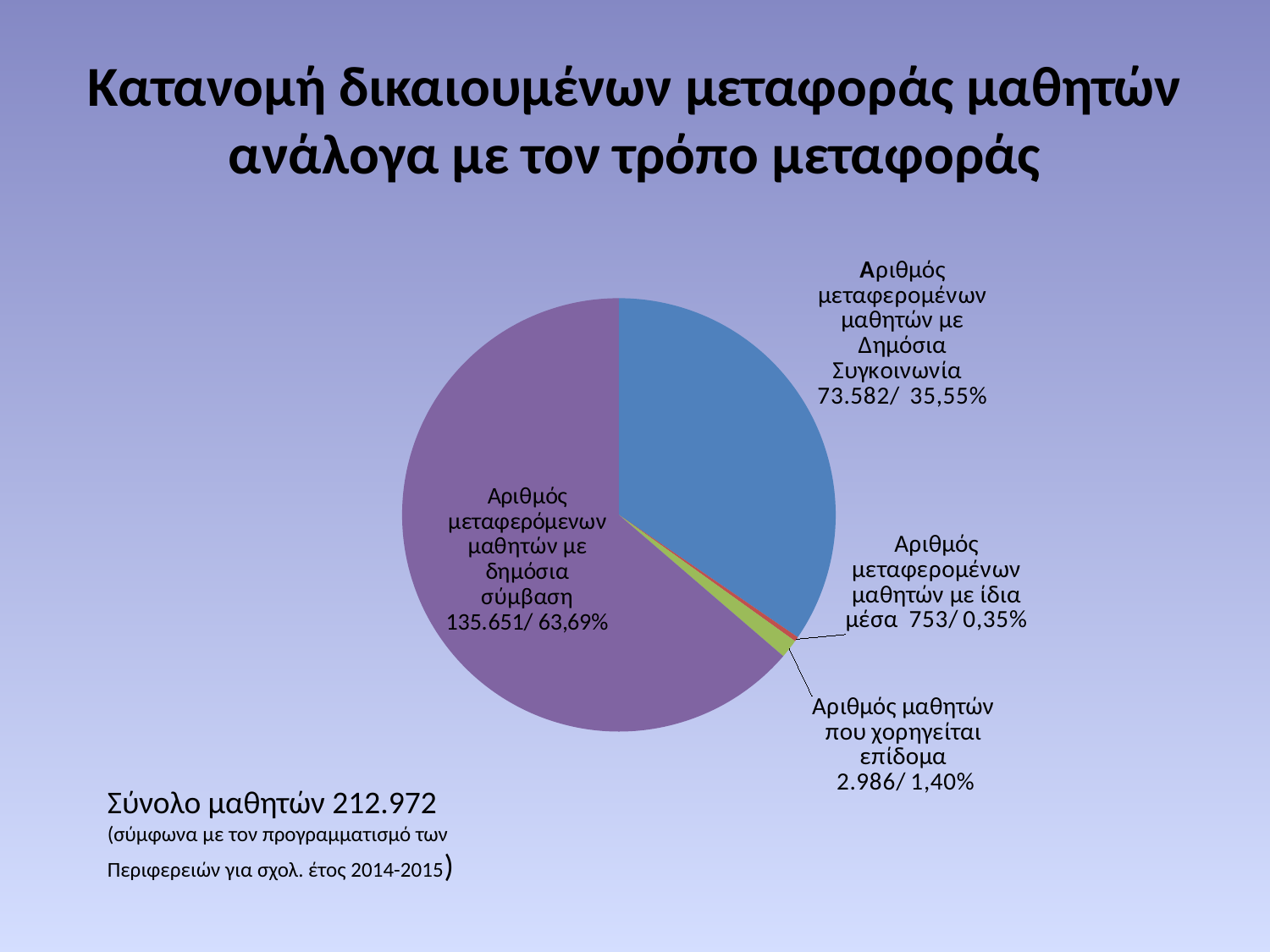
Which category has the largest share of the pie? Αριθμός μεταφερόμενων μαθητών με δημόσια σύμβαση What colour is the slice for students transported by public transport (Δημόσια Συγκοινωνία)? Blue How many slices does the pie chart have? 4 What percentage of students are transported by public transport (Δημόσια Συγκοινωνία)? 35,55% Which category has the smallest share of the pie? Αριθμός μεταφερομένων μαθητών με ίδια μέσα What is the total number of students stated on the slide? 212.972 What is the difference in number of students between public contract (δημόσια σύμβαση) and public transport (Δημόσια Συγκοινωνία)? 62.069 What is the number of students transported by their own means (ίδια μέσα)? 753 What kind of chart is shown on the slide? Pie chart What percentage of students receive an allowance (επίδομα)? 1,40% Which is larger: the number of students receiving an allowance (επίδομα) or the number transported by their own means (ίδια μέσα)? Αριθμός μαθητών που χορηγείται επίδομα What is the number of students transported by public contract (δημόσια σύμβαση)? 135.651